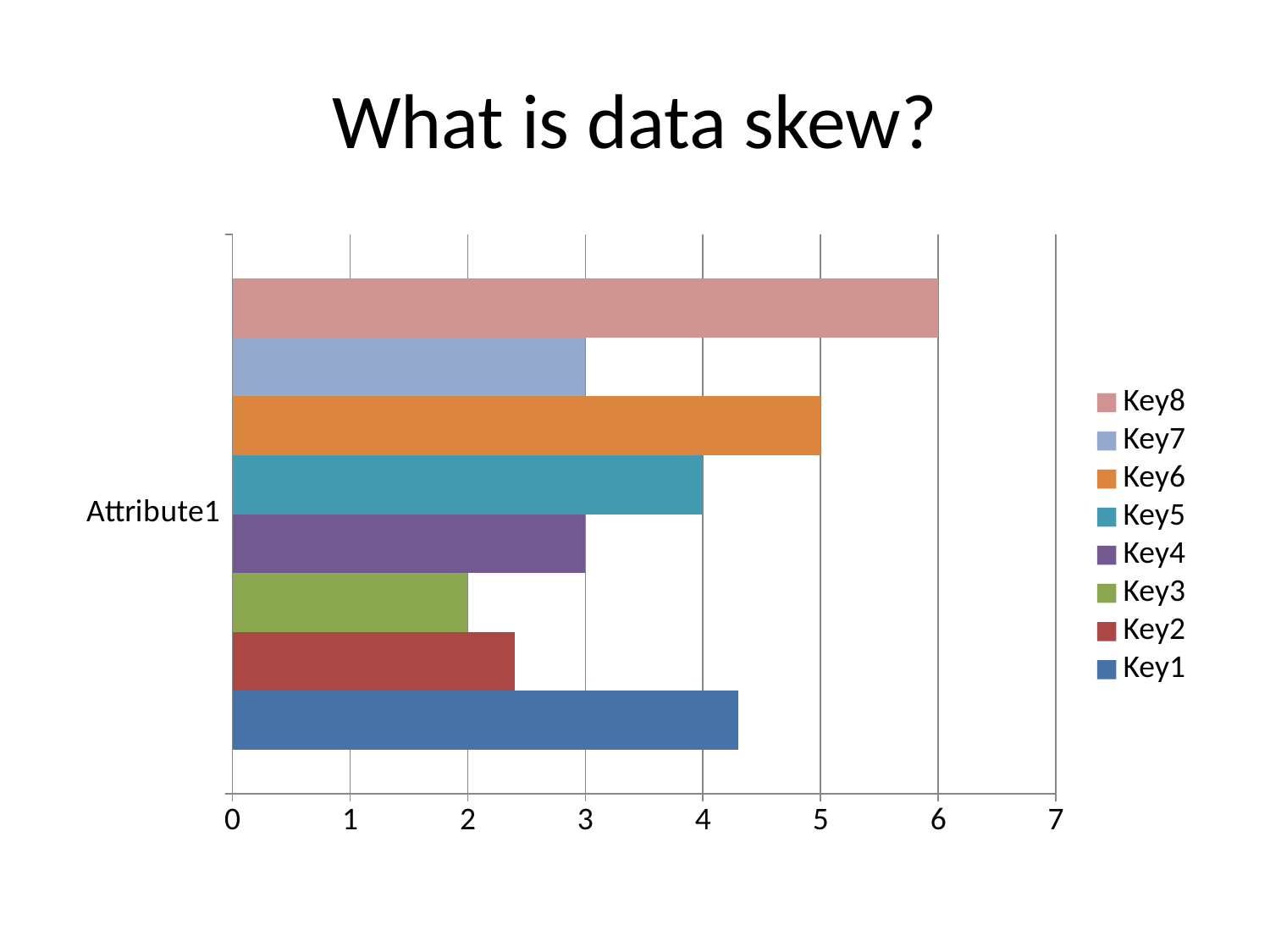
Which series has the highest value? Key8 Is the value for Key1 greater or less than 4? greater What is the value for Key8? 6 How many series does the legend list? 8 What is the value for Key3? 2 How many categories are shown on the vertical axis? 1 What type of chart is shown on the slide? bar chart What is the value for Key6? 5 What is the value for Key5? 4 Which is larger, the value for Key5 or the value for Key7? Key5 What is the difference between the values for Key8 and Key6? 1 Which series has the lowest value? Key3